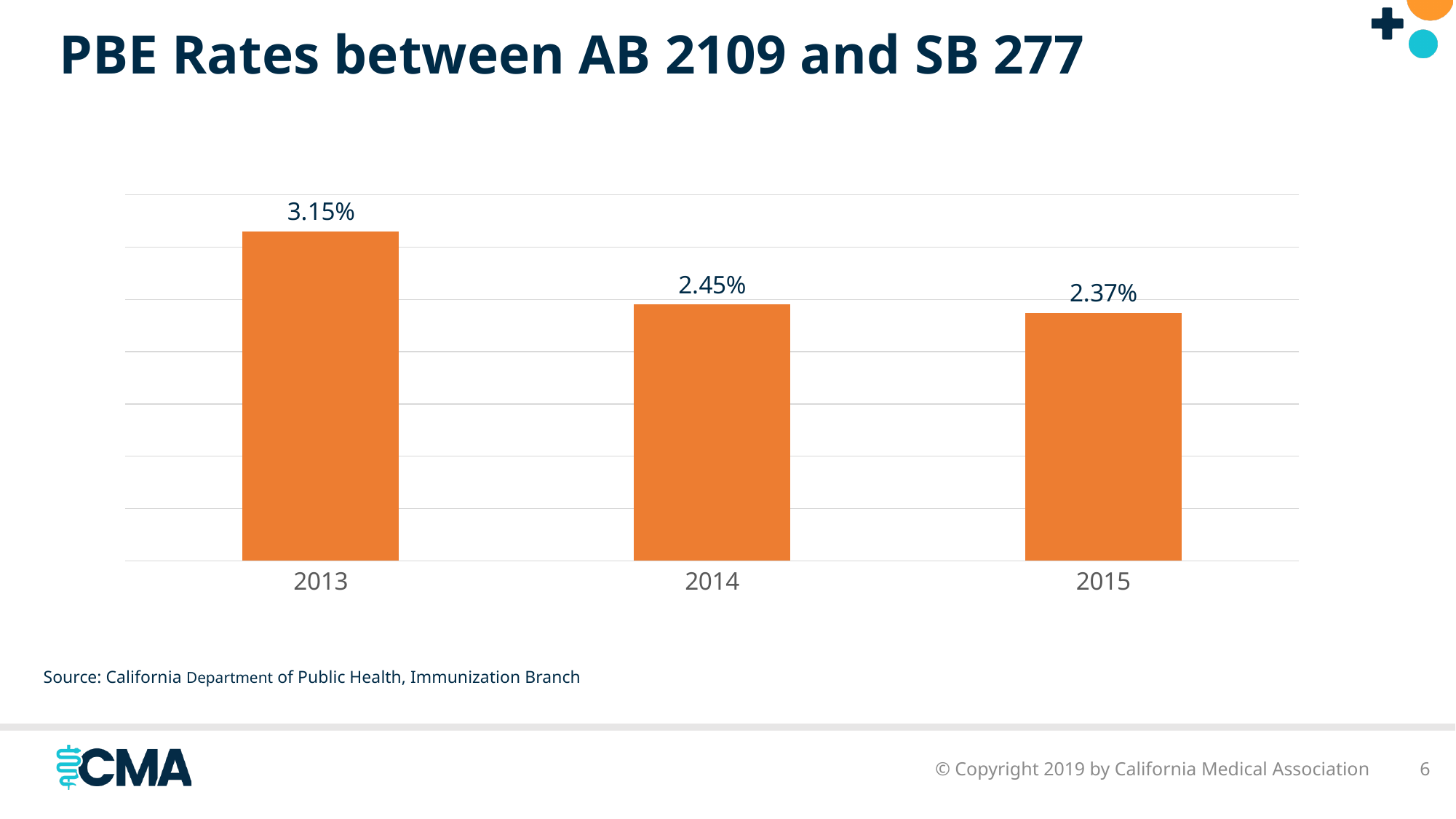
What is the PBE rate for 2014? 2.45% What is the PBE rate for 2015? 2.37% Which year has the lowest PBE rate? 2015 What is the PBE rate for 2013? 3.15% Do the PBE rates rise or fall from 2013 to 2015? Fall What is the title of the chart? PBE Rates between AB 2109 and SB 277 What kind of chart is shown on the slide? Bar chart Which year has the highest PBE rate? 2013 What is the difference between the PBE rates for 2013 and 2014? 0.70% What is the difference between the PBE rates for 2014 and 2015? 0.08% How many years are shown on the chart? 3 Which year has a higher PBE rate, 2013 or 2015? 2013